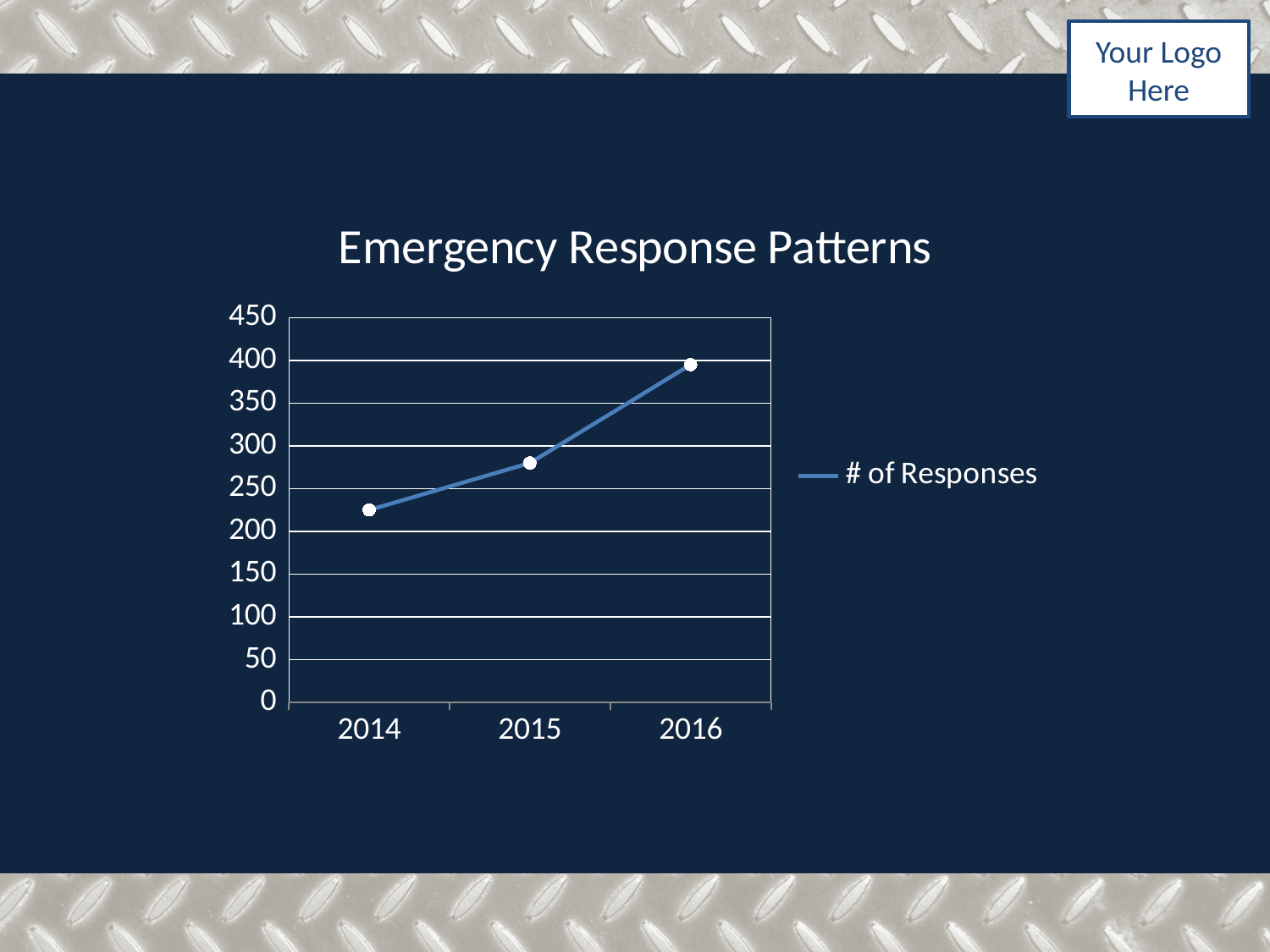
What is the name of the series shown in the legend? # of Responses Which year has more responses, 2014 or 2016? 2016 How many series does the legend list? 1 Which year has the highest number of responses? 2016 Is the value for 2015 greater or less than 300? less Do the values rise or fall from 2014 to 2016? rise What kind of chart is shown on the slide? line chart Is the value for 2016 greater or less than 350? greater How many years are plotted on the x axis? 3 What is the title of the chart? Emergency Response Patterns Which year has the lowest number of responses? 2014 Is the value for 2014 greater or less than 200? greater